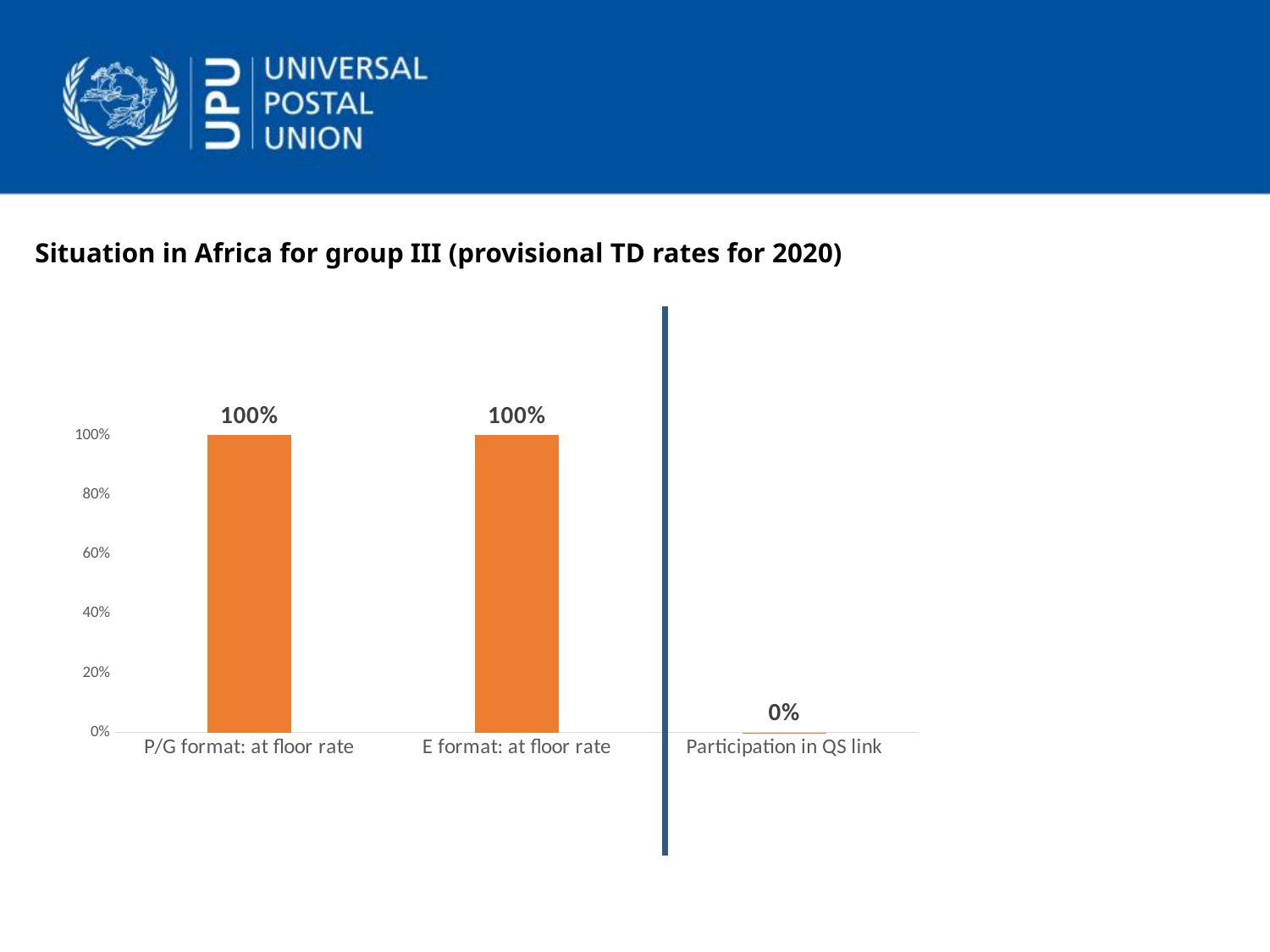
What is the value for P/G format: at floor rate? 100% What kind of chart is shown on the slide? bar chart Is the value for E format: at floor rate greater or less than 80%? greater What is the value for E format: at floor rate? 100% Is the value for Participation in QS link greater or less than 20%? less What is the title of the slide above the chart? Situation in Africa for group III (provisional TD rates for 2020) What colour are the bars in the chart? orange How many categories are shown on the x axis? 3 What is the difference between the values for E format: at floor rate and Participation in QS link? 100% Which category has the lowest value? Participation in QS link What is the value for Participation in QS link? 0% Which is larger, the value for P/G format: at floor rate or the value for Participation in QS link? P/G format: at floor rate